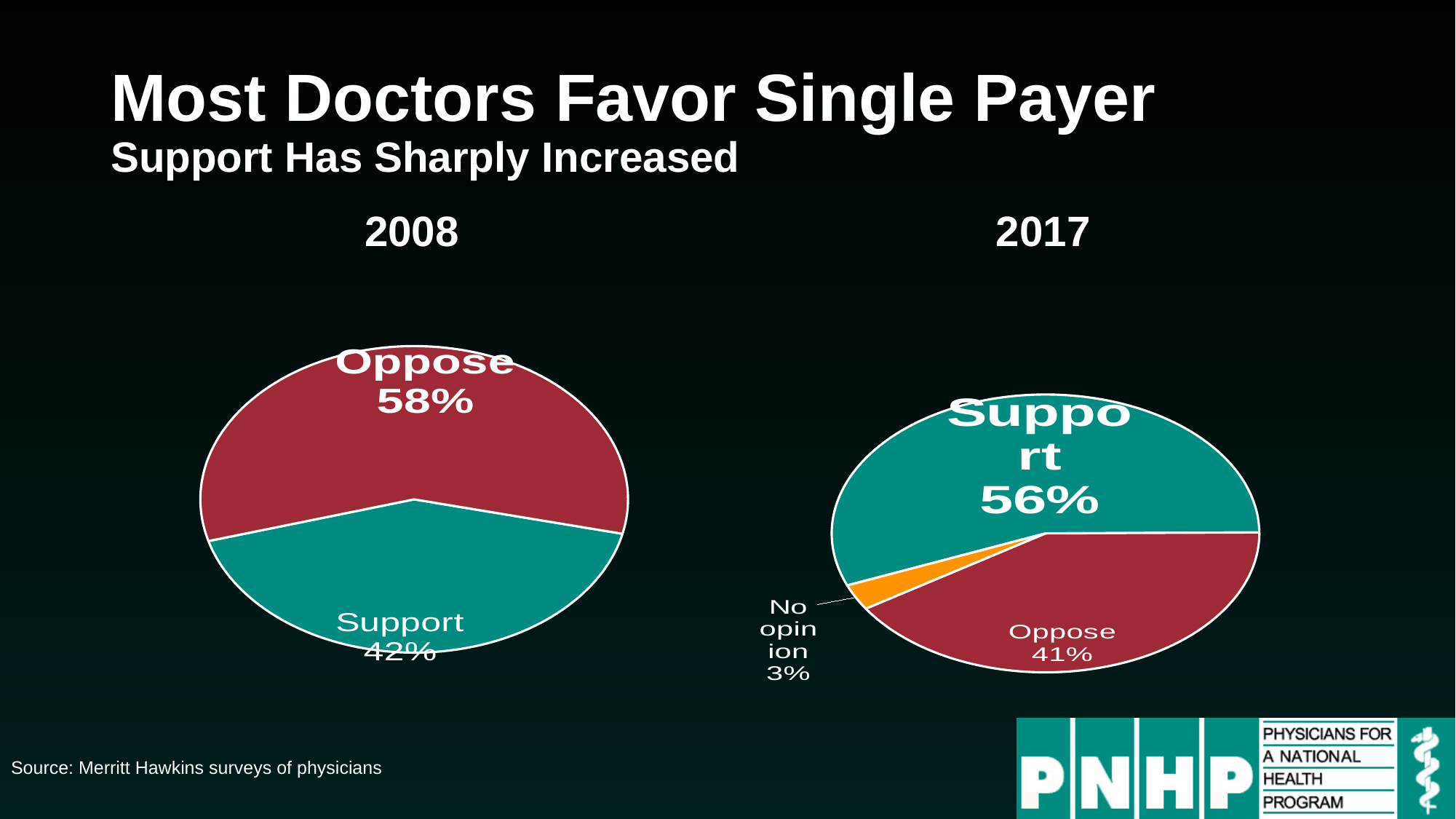
How many slices does the 2017 pie chart have? 3 What kind of chart is used for the 2008 data? Pie chart In the 2017 pie chart, what share of doctors had no opinion? 3% In the 2008 pie chart, what share of doctors supported single payer? 42% In the 2008 pie chart, what is the difference between the Oppose and Support shares? 16% In the 2017 pie chart, which slice is the smallest? No opinion In the 2008 pie chart, which is larger, Oppose or Support? Oppose In the 2017 pie chart, what share of doctors supported single payer? 56% In the 2017 pie chart, what share of doctors opposed single payer? 41% What colour is the Support slice in the 2017 pie chart? Teal In the 2017 pie chart, which slice is the largest? Support In the 2008 pie chart, what share of doctors opposed single payer? 58%